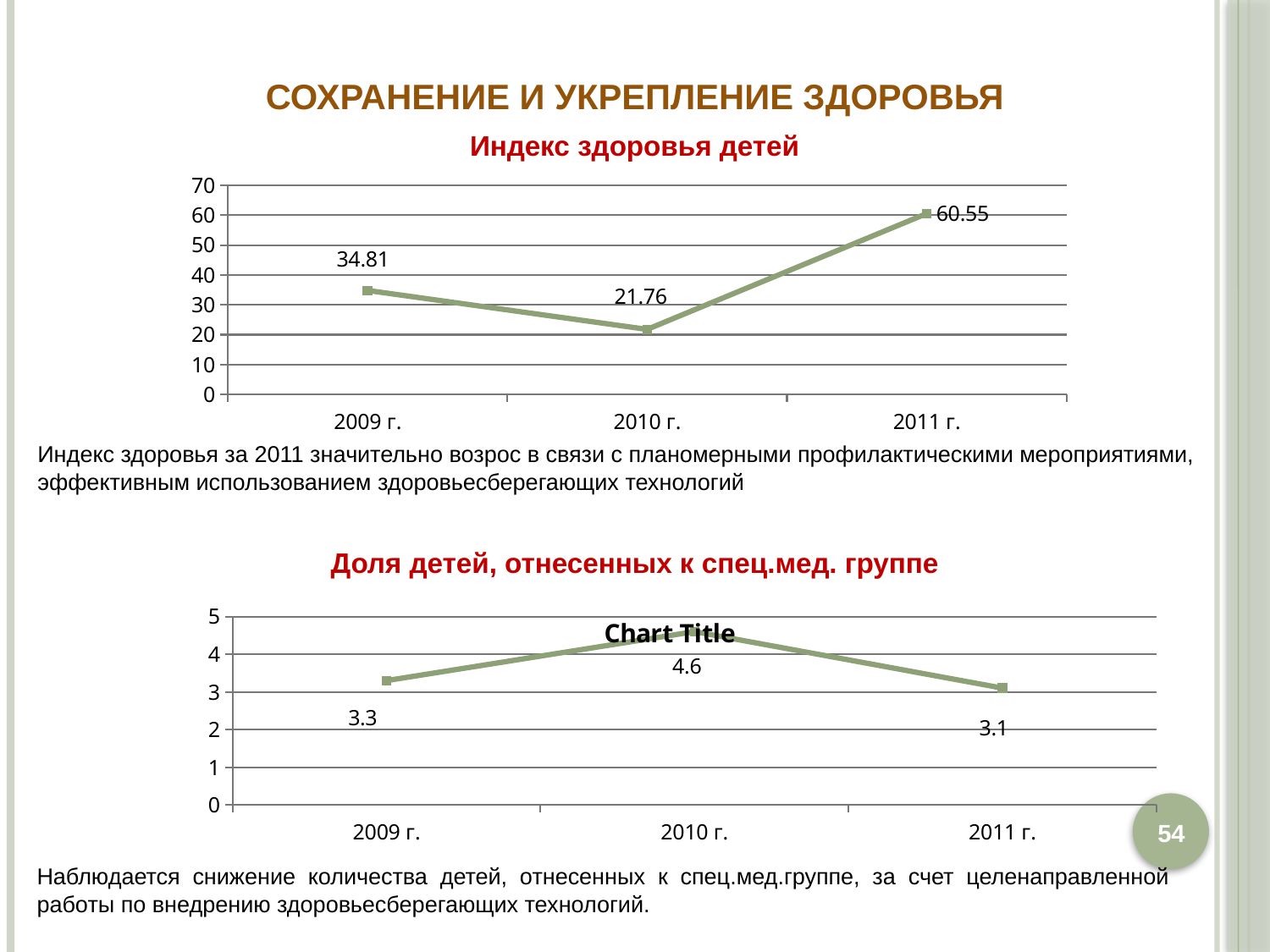
In the 'Индекс здоровья детей' chart, how many data points are plotted? 3 In the 'Индекс здоровья детей' chart, which year has the lowest value? 2010 г. In the 'Доля детей, отнесенных к спец.мед. группе' chart, what is the value for 2010 г.? 4.6 In the 'Доля детей, отнесенных к спец.мед. группе' chart, is the value for 2009 г. larger or smaller than the value for 2011 г.? Larger In the 'Индекс здоровья детей' chart, what is the value for 2009 г.? 34.81 What type of chart is the 'Индекс здоровья детей' chart? Line chart In the 'Доля детей, отнесенных к спец.мед. группе' chart, which year has the highest value? 2010 г. In the 'Индекс здоровья детей' chart, which year has the highest value? 2011 г. In the 'Доля детей, отнесенных к спец.мед. группе' chart, what is the value for 2011 г.? 3.1 In the 'Индекс здоровья детей' chart, what is the difference between the values for 2011 г. and 2010 г.? 38.79 In the 'Доля детей, отнесенных к спец.мед. группе' chart, what is the difference between the values for 2010 г. and 2009 г.? 1.3 In the 'Индекс здоровья детей' chart, what is the value for 2011 г.? 60.55